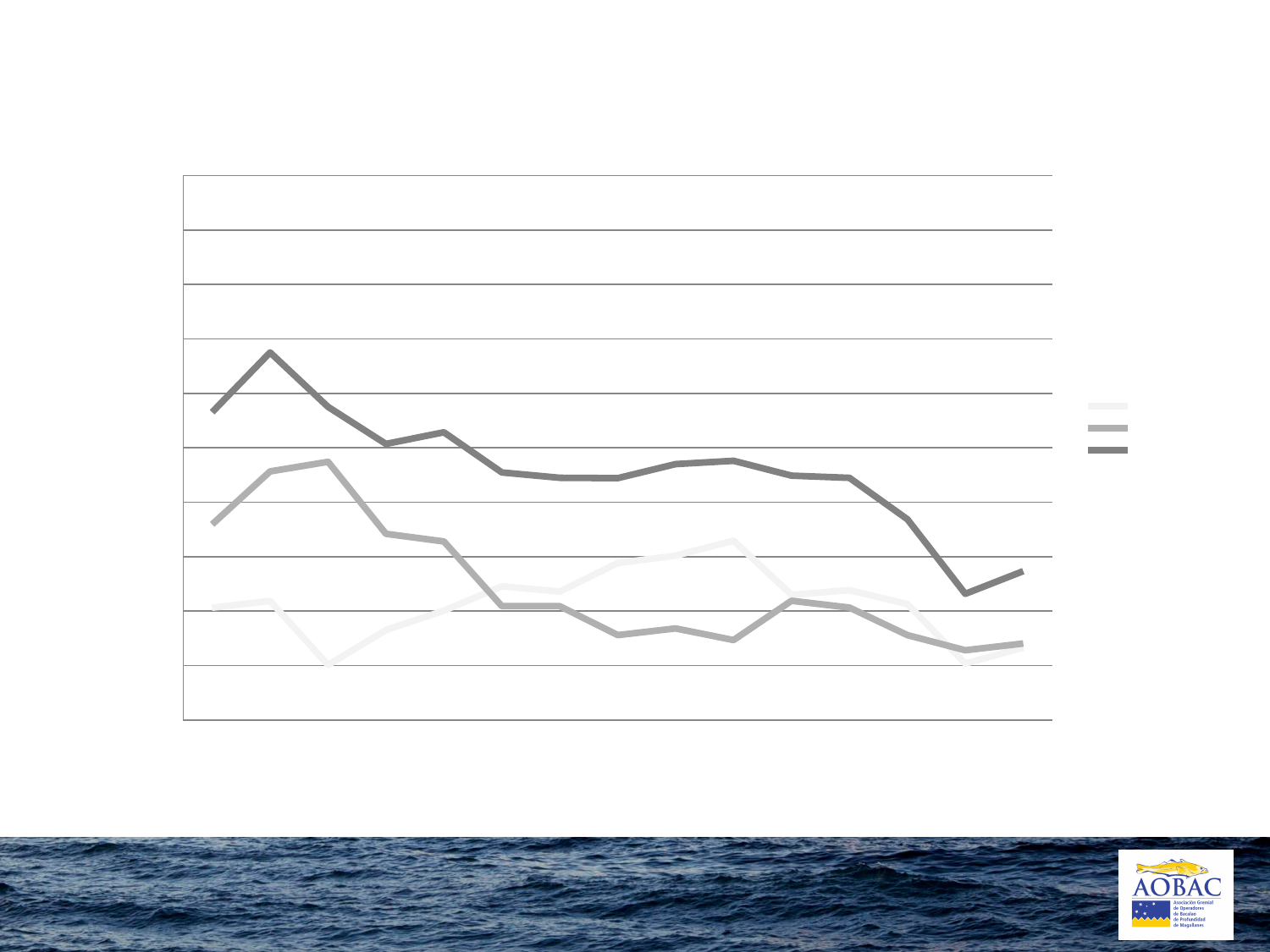
Does the medium gray line rise or fall overall from left to right? fall How many series does the legend on the right of the chart list? 3 Which line is highest at the leftmost point of the chart? the darkest gray line Which line is highest at the rightmost point of the chart? the darkest gray line How many data points does each line on the chart have? 15 Which line is lowest at the leftmost point of the chart? the lightest (white) line Where is the legend placed relative to the plot area? to the right What kind of chart is shown on the slide? line chart How many lines are plotted on the chart? 3 Does the darkest gray line rise or fall overall from left to right? fall